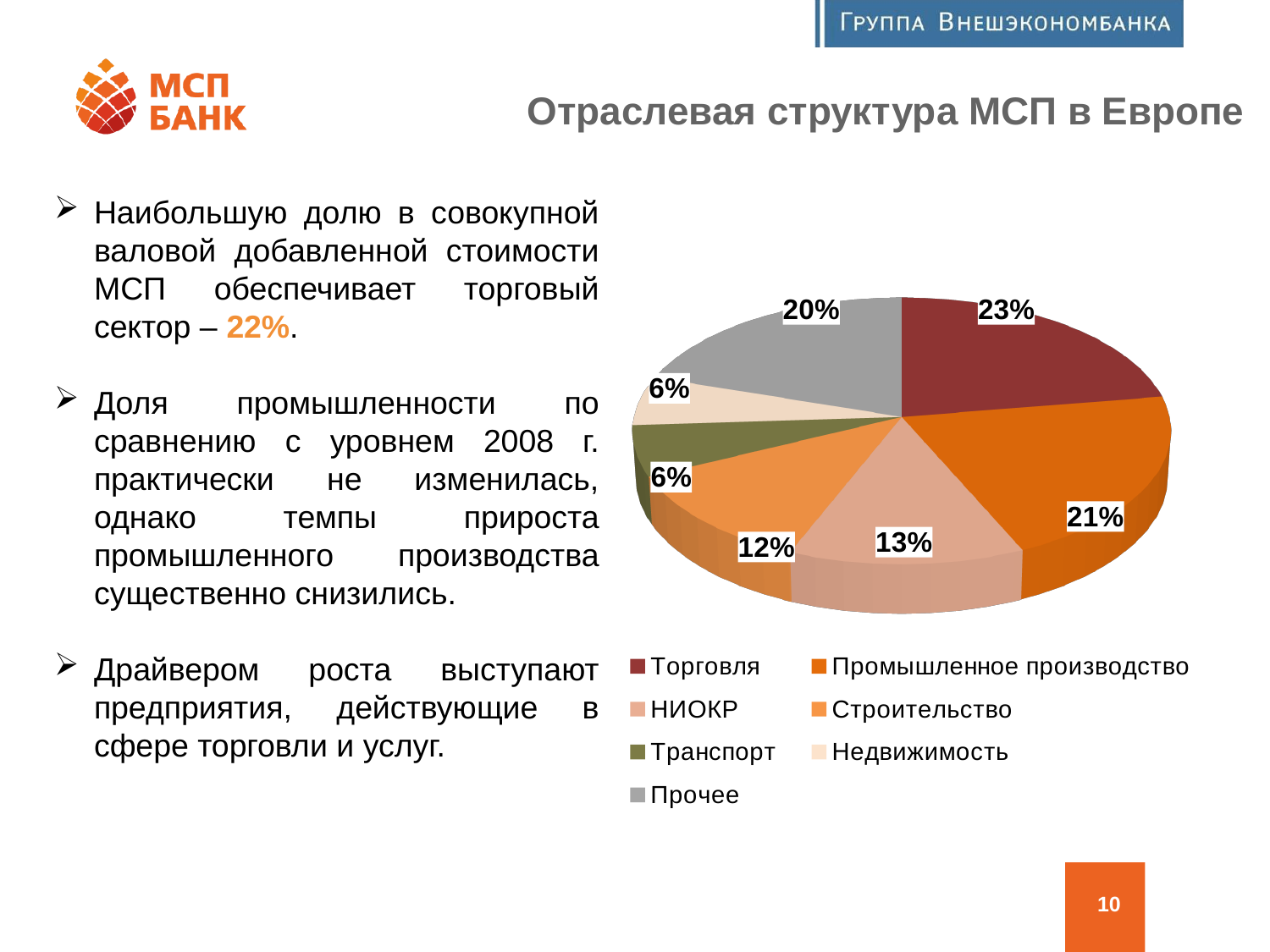
What type of chart is shown on the slide? Pie chart How many categories does the pie chart have? 7 What is the difference in percentage points between the shares of Торговля and Строительство? 11 What share of the pie does Строительство have? 12% What share of the pie does НИОКР have? 13% What share of the pie does Промышленное производство have? 21% What share of the pie does Прочее have? 20% Which category has the largest share of the pie? Торговля What colour is the Прочее slice in the pie chart? Gray Which has a larger share, НИОКР or Прочее? Прочее What share of the pie does Торговля have? 23% Which two categories have the smallest share of the pie? Транспорт and Недвижимость